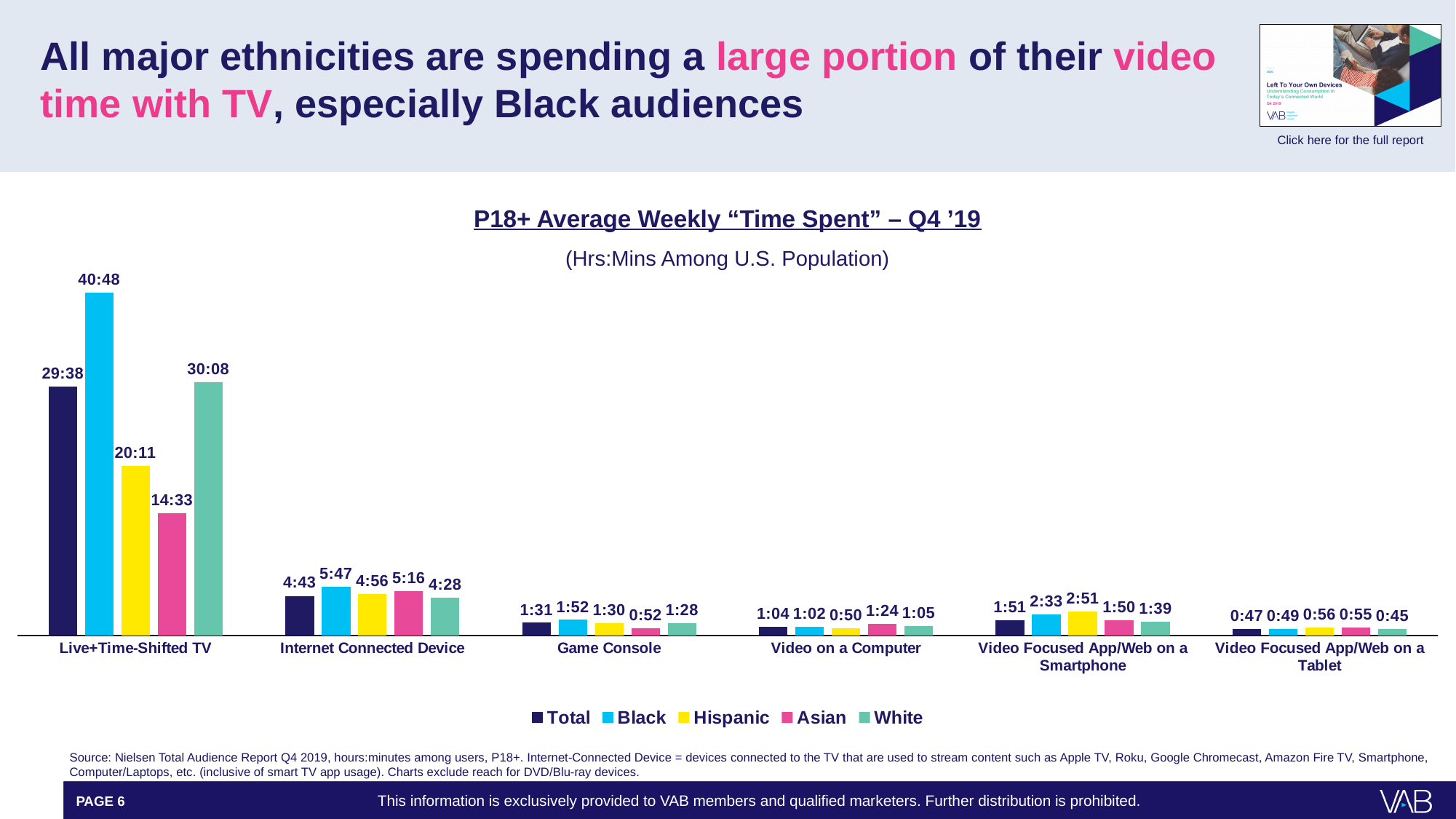
What is the White value for Internet Connected Device? 4:28 What kind of chart is shown on the slide? Bar chart How many series does the legend list? 5 How many categories are shown on the x axis? 6 Which series has the lowest value for Game Console? Asian What is the title of the chart? P18+ Average Weekly "Time Spent" – Q4 '19 What is the Hispanic value for Video Focused App/Web on a Smartphone? 2:51 Which is larger for Internet Connected Device: the Black value or the Asian value? Black What is the difference between the Black and Total values for Live+Time-Shifted TV? 11:10 Which series has the highest value for Live+Time-Shifted TV? Black What is the Black value for Live+Time-Shifted TV? 40:48 What is the Asian value for Video on a Computer? 1:24